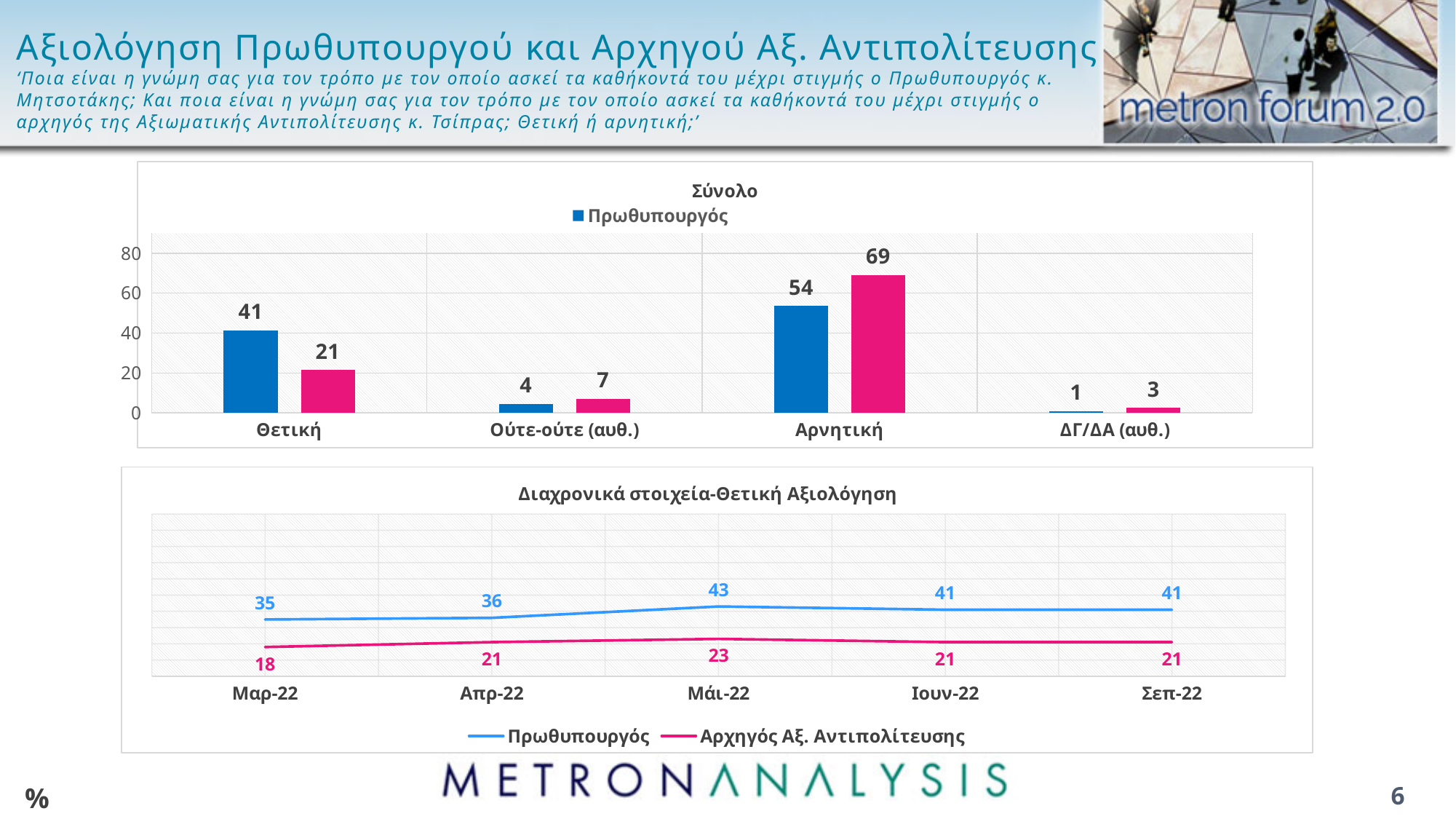
In the top chart titled 'Σύνολο', which category has the highest value for the Πρωθυπουργός (blue) series? Αρνητική In the top chart titled 'Σύνολο', what is the difference between the pink bar and the blue bar for Αρνητική? 15 In the top chart titled 'Σύνολο', what is the value of the Πρωθυπουργός (blue) bar for Θετική? 41 In the bottom chart 'Διαχρονικά στοιχεία-Θετική Αξιολόγηση', what is the difference between Πρωθυπουργός and Αρχηγός Αξ. Αντιπολίτευσης in Σεπ-22? 20 In the top chart titled 'Σύνολο', what is the value of the pink bar for Αρνητική? 69 In the bottom chart 'Διαχρονικά στοιχεία-Θετική Αξιολόγηση', what is the value for Πρωθυπουργός in Μάι-22? 43 What kind of chart is the top chart titled 'Σύνολο'? Bar chart In the bottom chart 'Διαχρονικά στοιχεία-Θετική Αξιολόγηση', how many series does the legend list? 2 In the bottom chart 'Διαχρονικά στοιχεία-Θετική Αξιολόγηση', in which month does Πρωθυπουργός reach its highest value? Μάι-22 In the top chart titled 'Σύνολο', how many categories are shown on the x axis? 4 In the bottom chart 'Διαχρονικά στοιχεία-Θετική Αξιολόγηση', what is the value for Αρχηγός Αξ. Αντιπολίτευσης in Μαρ-22? 18 In the top chart titled 'Σύνολο', which category has the lowest value for the Πρωθυπουργός (blue) series? ΔΓ/ΔΑ (αυθ.)